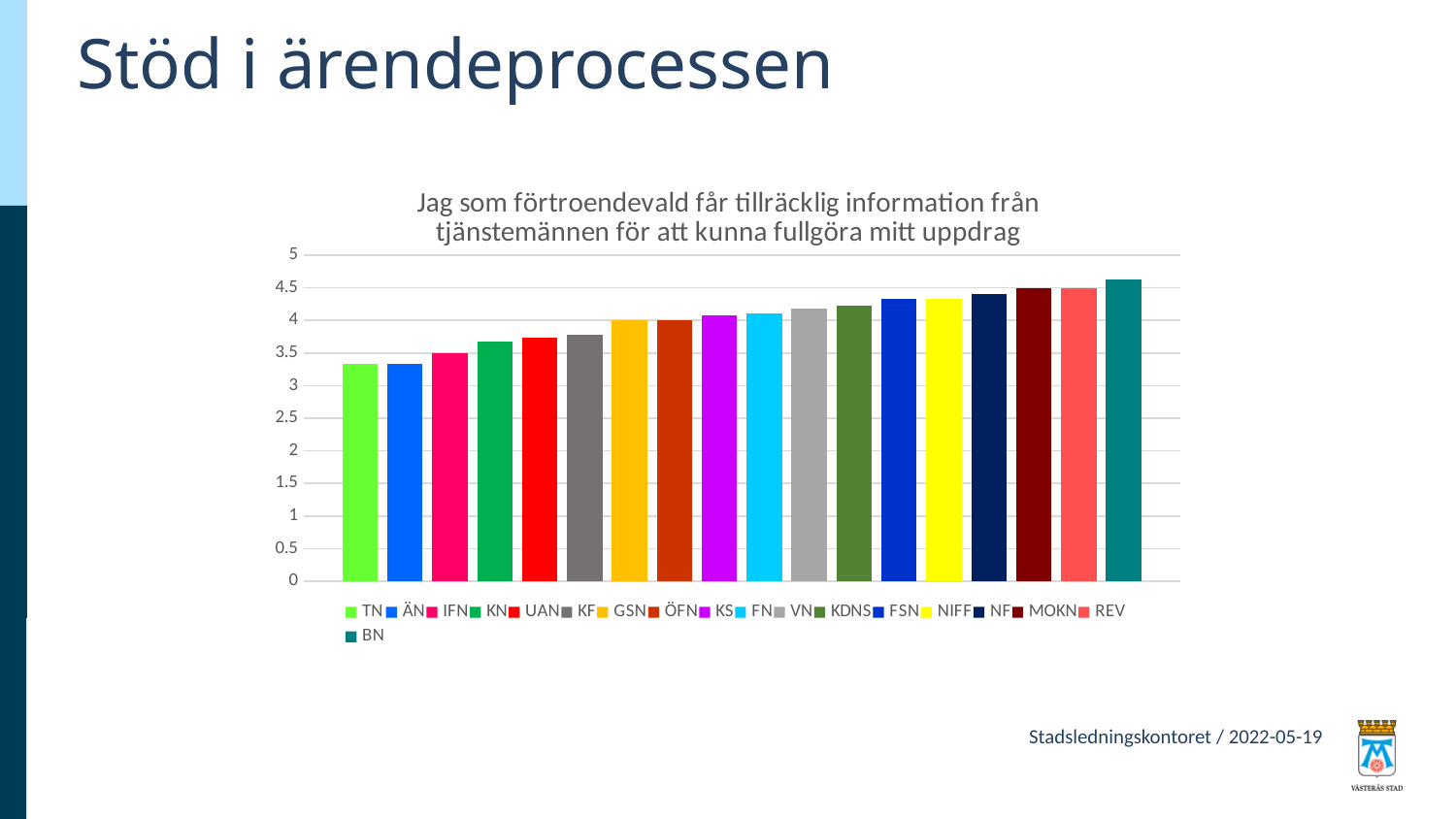
Is the value for BN greater or less than 4.5? greater Which has the larger value, BN or TN? BN Is the value for TN greater or less than 3.5? less What kind of chart is shown on the slide? bar chart How many bars are plotted in the chart? 18 Is the value for FSN greater or less than 4? greater What is the title of the chart? Jag som förtroendevald får tillräcklig information från tjänstemännen för att kunna fullgöra mitt uppdrag Which legend entry has the highest bar in the chart? BN How many entries does the chart legend list? 18 Do the bar values generally rise or fall from left to right across the chart? rise